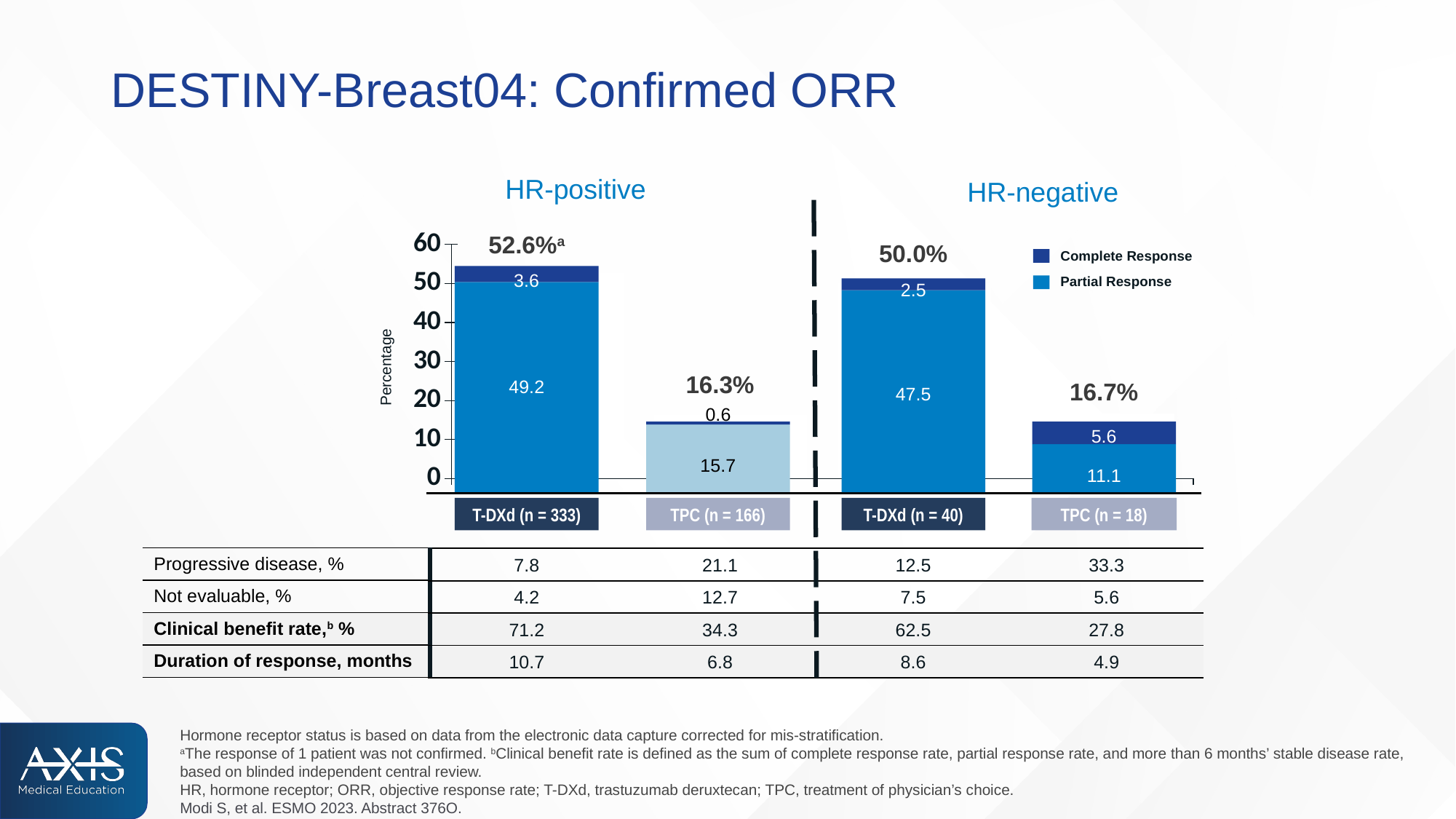
How many series does the legend list? 2 What kind of chart is shown on the slide? Stacked bar chart Which has a larger partial response value: T-DXd (n = 333) in the HR-positive panel or T-DXd (n = 40) in the HR-negative panel? T-DXd (n = 333) What confirmed ORR is printed above the T-DXd (n = 40) bar in the HR-negative panel? 50.0% Which bar has the highest confirmed ORR across both panels? T-DXd (n = 333) What is the complete response value for TPC (n = 18) in the HR-negative panel? 5.6 In the HR-negative panel, what is the difference between the complete response values for TPC (n = 18) and T-DXd (n = 40)? 3.1 How many bars are plotted in the chart across both panels? 4 Which bar has the lowest partial response value across both panels? TPC (n = 18) What is the partial response value for T-DXd (n = 333) in the HR-positive panel? 49.2 In the HR-positive panel, what is the difference between the partial response values for T-DXd (n = 333) and TPC (n = 166)? 33.5 What confirmed ORR is printed above the TPC (n = 166) bar in the HR-positive panel? 16.3%